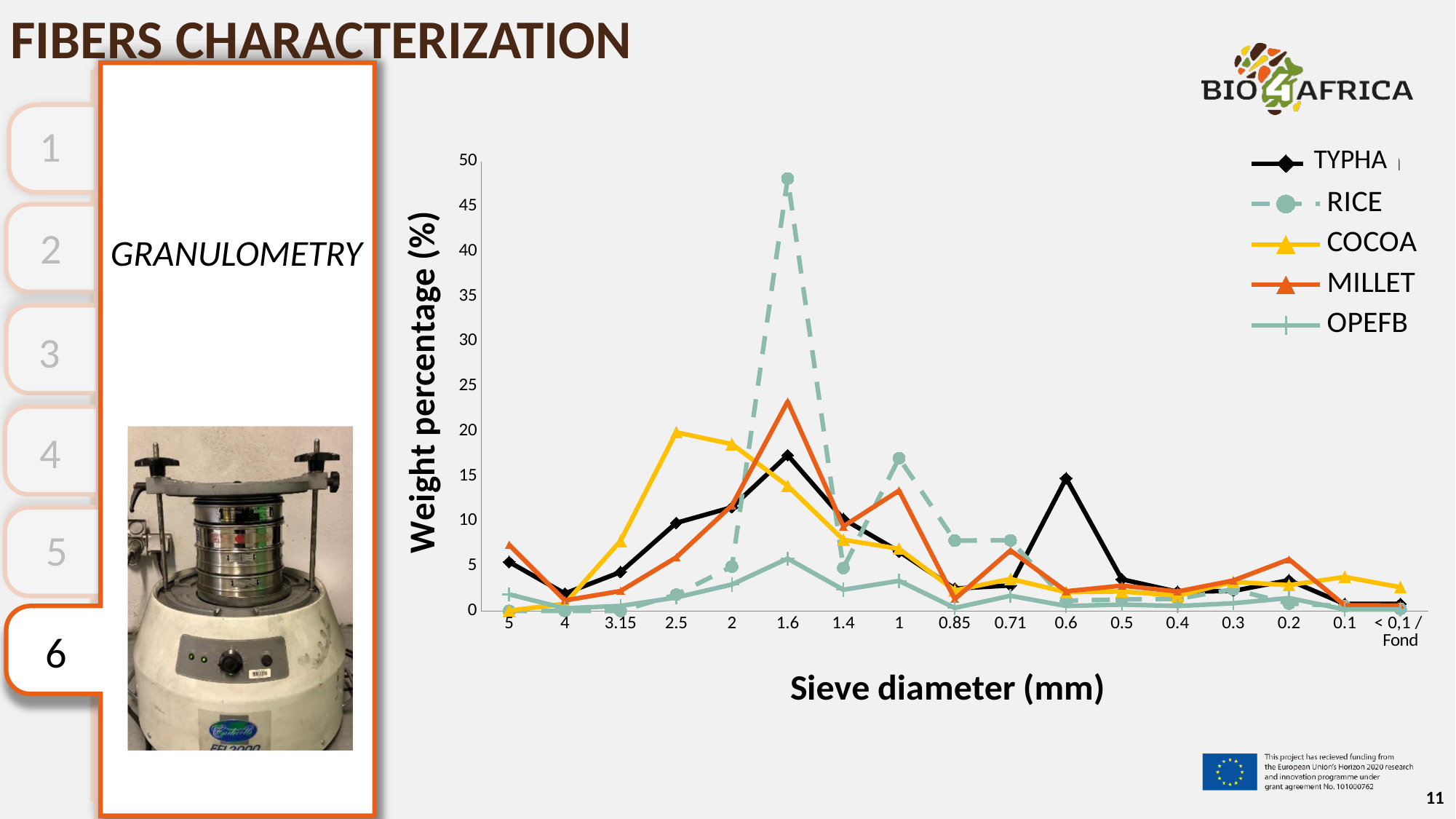
What kind of chart is shown on the slide? line chart Is the value for RICE at sieve diameter 1.6 greater or less than 45? greater Is the value for TYPHA at sieve diameter 0.6 greater or less than 10? greater How many sieve diameter categories are shown on the x axis? 17 How many series does the chart legend list? 5 What is the title of the vertical axis of the chart? Weight percentage (%) At which sieve diameter does the RICE series reach its peak? 1.6 At sieve diameter 2.5, which series has the larger value, COCOA or MILLET? COCOA At which sieve diameter does the COCOA series reach its peak? 2.5 Which series reaches the highest weight percentage on the chart? RICE At sieve diameter 0.6, which series has the larger value, TYPHA or RICE? TYPHA Is the value for OPEFB at sieve diameter 1.6 greater or less than 10? less